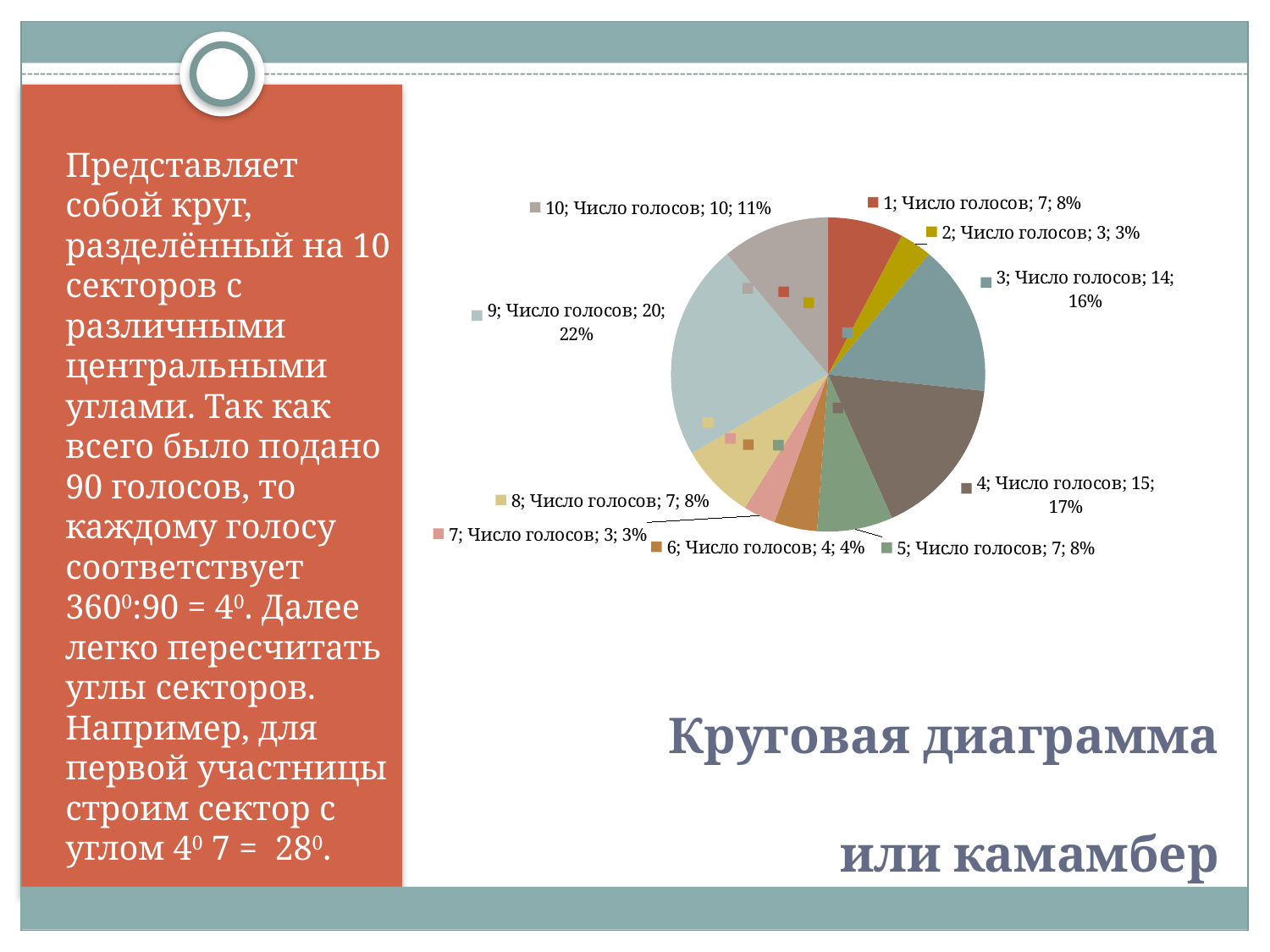
What is the number of votes (Число голосов) for category 9? 20 What is the percentage share of category 10? 11% What percentage share does category 4 have in the pie chart? 17% What is the number of votes for category 3? 14 How many slices (categories) does the pie chart have? 10 What is the difference in votes between category 9 and category 4? 5 What is the name of the data series shown in the pie chart labels? Число голосов What is the total number of votes across all slices of the pie chart? 90 Which category has the largest share of the pie? 9 Which has more votes, category 3 or category 6? category 3 What kind of chart is shown on the slide? pie chart What is the number of votes for category 6? 4